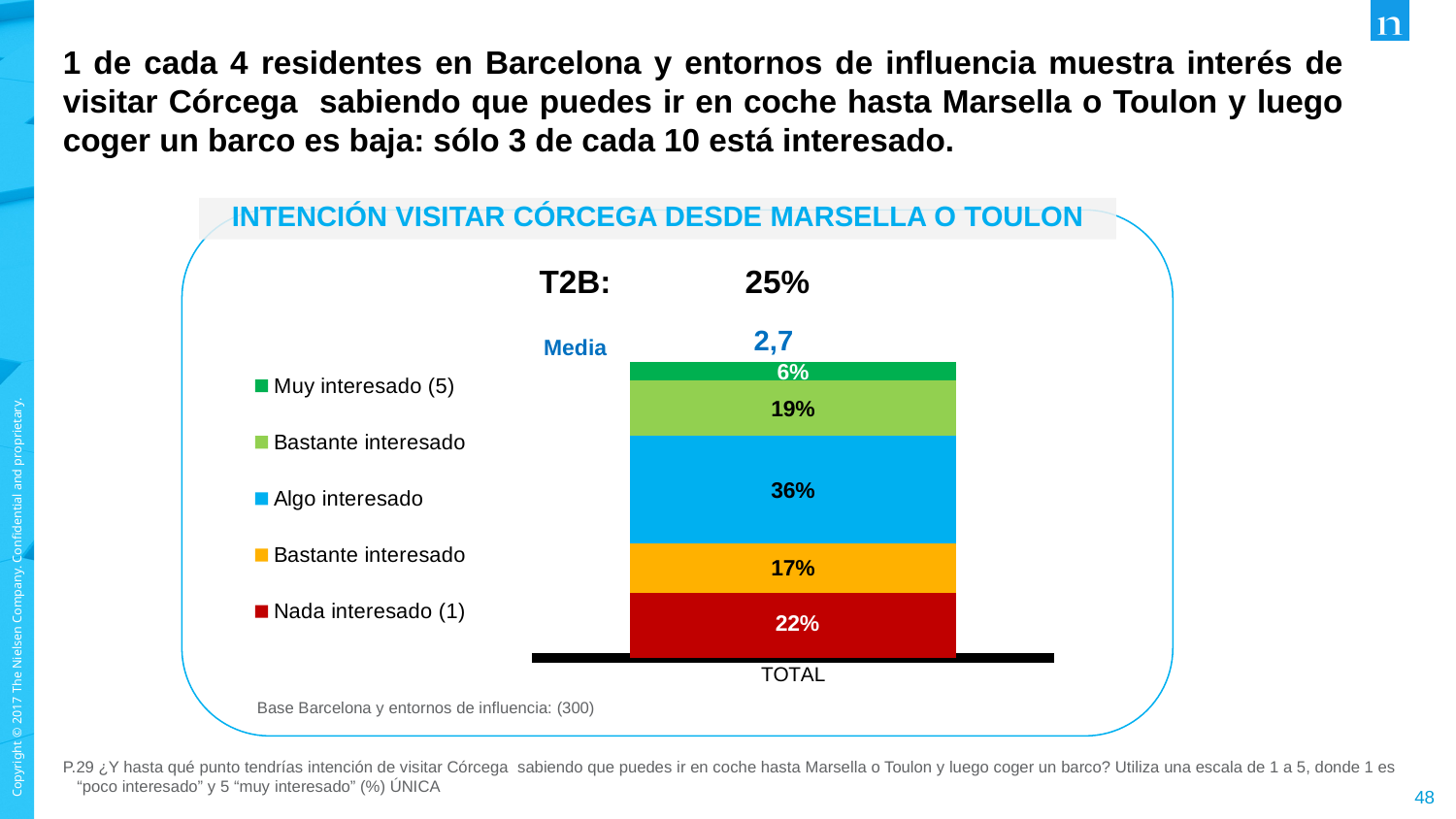
What percentage is shown for 'Nada interesado (1)' in the TOTAL bar? 22% Which is larger, the value for 'Algo interesado' or the value for 'Nada interesado (1)'? Algo interesado How many series does the legend list? 5 What is the difference between the 'Nada interesado (1)' and 'Muy interesado (5)' percentages? 16% What is the total of all segments in the TOTAL stacked bar? 100% Which segment of the stacked bar has the largest value? Algo interesado What percentage is shown for 'Algo interesado' in the TOTAL bar? 36% What percentage is shown for 'Muy interesado (5)' in the TOTAL bar? 6% What is the difference between the 'Algo interesado' and 'Nada interesado (1)' percentages? 14% What kind of chart is shown on the slide? Stacked bar chart Which segment of the stacked bar has the smallest value? Muy interesado (5) How many categories are plotted on the x axis? 1